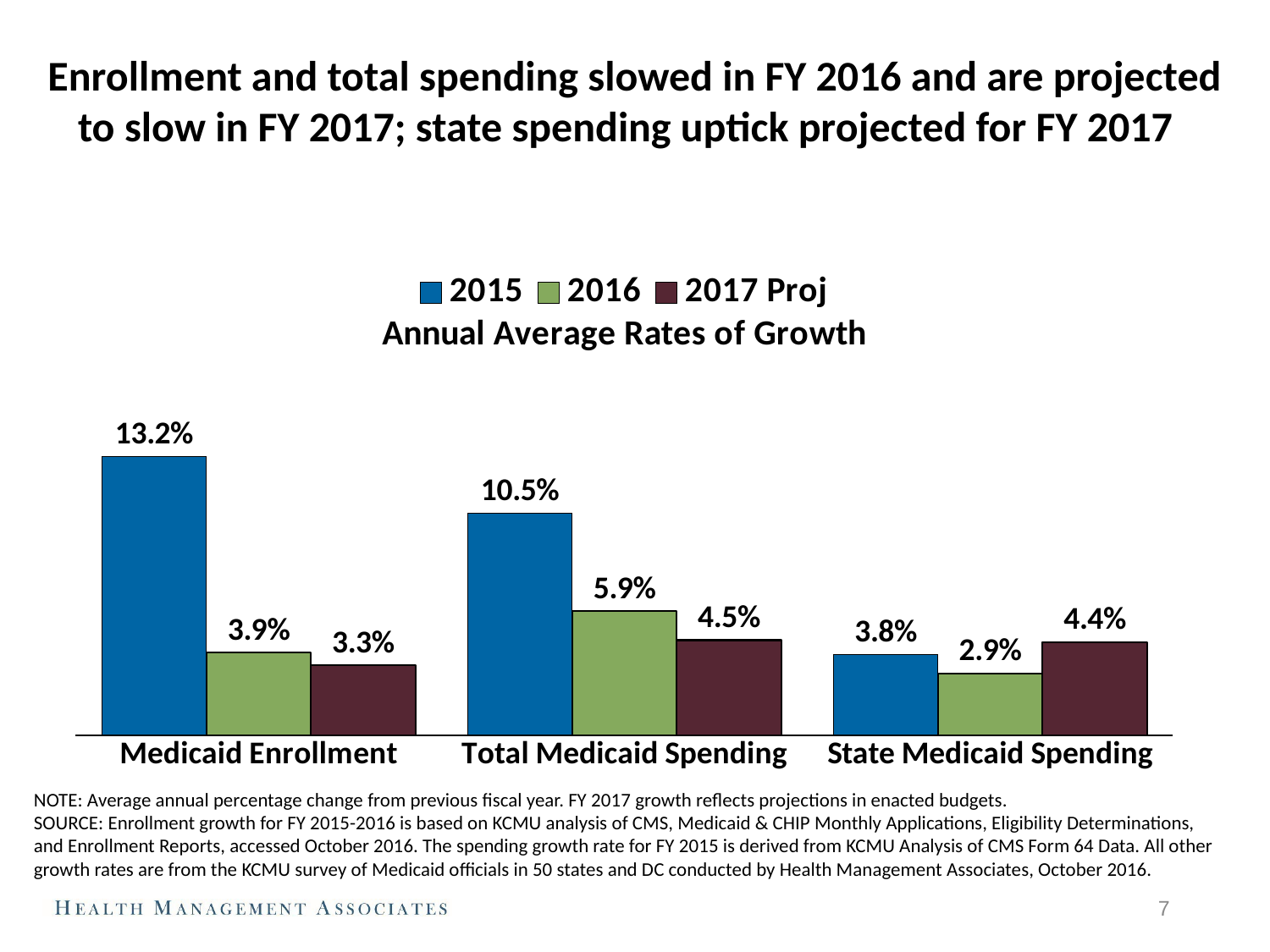
What is the title of the chart? Annual Average Rates of Growth How many series does the legend list? 3 What is the difference between the 2016 and 2017 Proj values for State Medicaid Spending? 1.5% Which is larger for Total Medicaid Spending: the 2016 value or the 2017 Proj value? 2016 What is the 2017 Proj value for State Medicaid Spending? 4.4% How many categories are shown on the x axis? 3 What is the 2015 value for Medicaid Enrollment? 13.2% Which category has the highest 2015 value? Medicaid Enrollment What is the 2016 value for Total Medicaid Spending? 5.9% What is the difference between the 2015 and 2016 values for Medicaid Enrollment? 9.3% What kind of chart is shown on the slide? Bar chart Which category has the lowest 2016 value? State Medicaid Spending